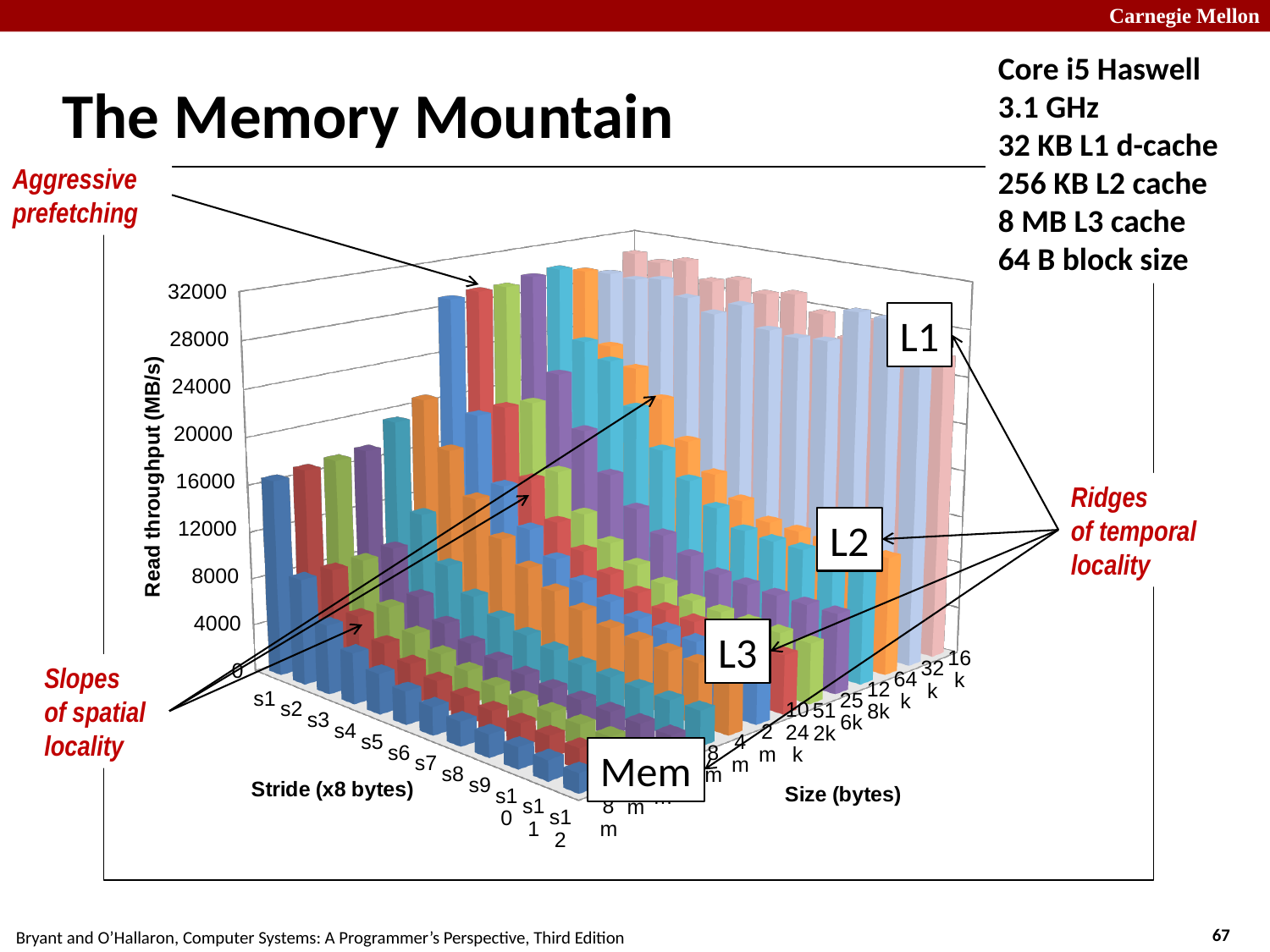
What is the label of the vertical axis of the chart? Read throughput (MB/s) Is the highest read throughput plotted on the chart greater or less than 20000? greater For a fixed size, does read throughput generally rise or fall as the stride increases from s1 to s12? fall What is the highest tick value shown on the Read throughput (MB/s) axis? 32000 Which stride category has the highest read throughput for the smallest sizes, s1 or s12? s1 For a fixed stride, does read throughput generally rise or fall as the working-set size increases from 16k toward 128m? fall Which region of the chart has higher read throughput, the L1 region or the Mem region? L1 How many stride categories are shown along the Stride (x8 bytes) axis? 12 What is the first stride category label on the Stride (x8 bytes) axis? s1 What kind of chart is shown on the slide? 3D bar chart